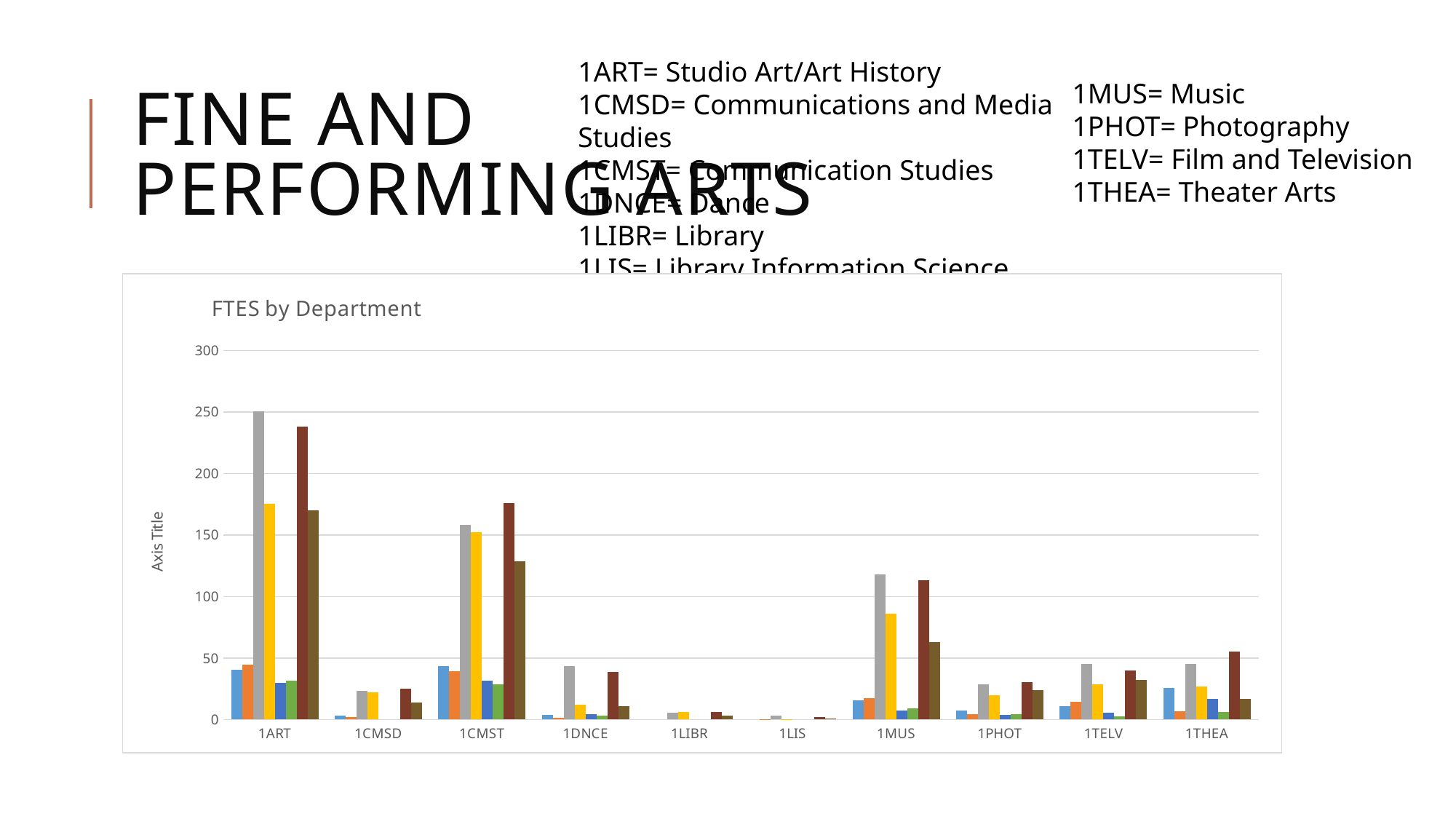
Which has the taller gray bar, 1ART or 1CMST? 1ART Is the dark brown bar for 1ART greater or less than 200? greater What is the title of the chart? FTES by Department How many departments (categories) are shown on the x axis of the chart? 10 What kind of chart is shown on the slide? bar chart What is the label on the vertical axis of the chart? Axis Title Is the dark brown bar for 1CMST greater or less than 150? greater Is the gray bar for 1DNCE greater or less than 50? less Which has the taller dark brown bar, 1MUS or 1THEA? 1MUS Which department has the tallest bar in the chart? 1ART